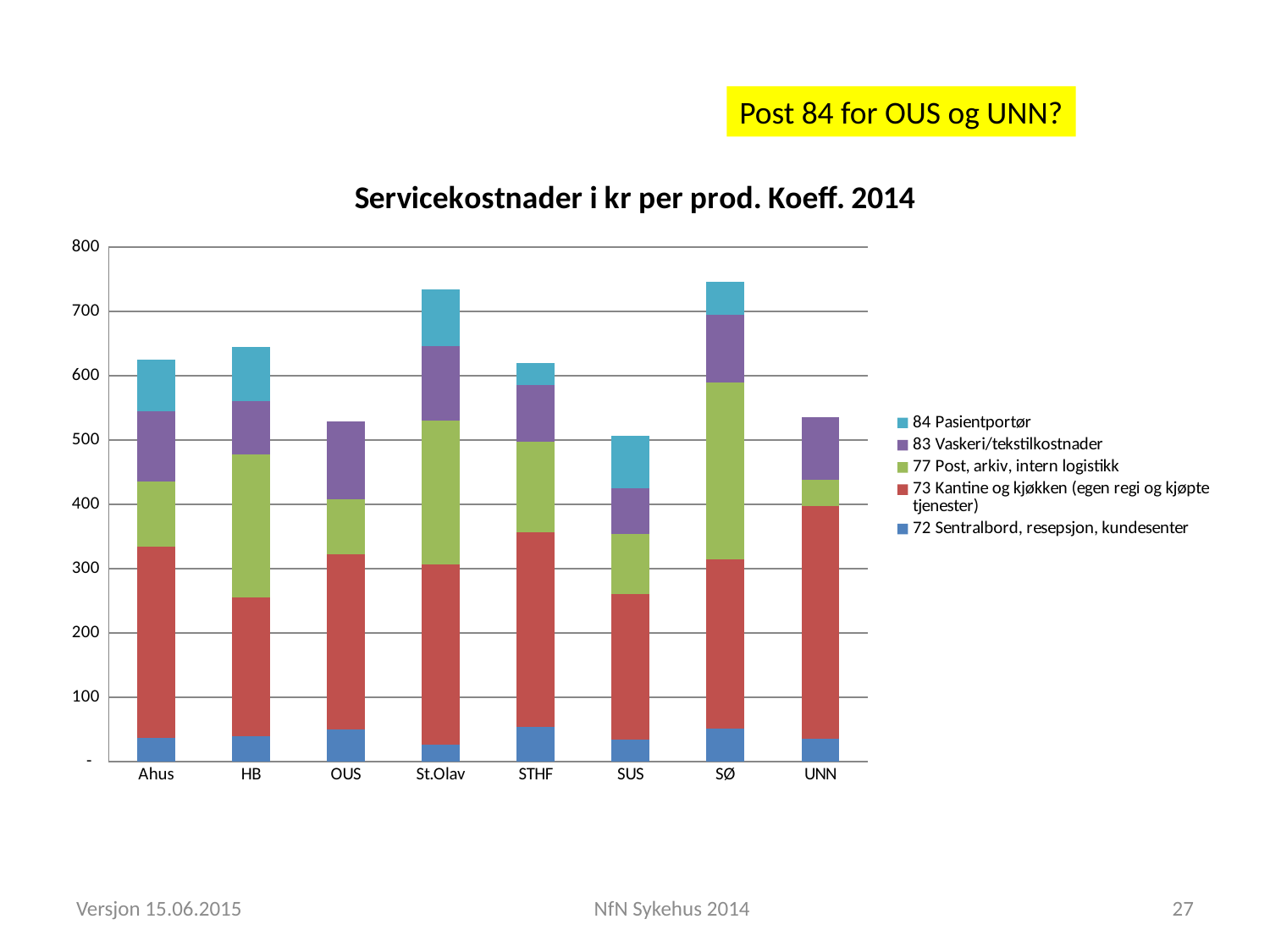
Is the total stacked value for UNN greater or less than 600? less Is the total stacked value for SØ greater or less than 700? greater How many hospitals (categories) are shown on the x axis? 8 Is the total stacked value for SUS greater or less than 600? less What is the title of the chart? Servicekostnader i kr per prod. Koeff. 2014 Which hospitals have no 84 Pasientportør segment in their bar? OUS and UNN Which has the taller total bar, SØ or UNN? SØ What kind of chart is shown on the slide? bar chart Which has the larger 73 Kantine og kjøkken segment, UNN or HB? UNN How many series does the legend list? 5